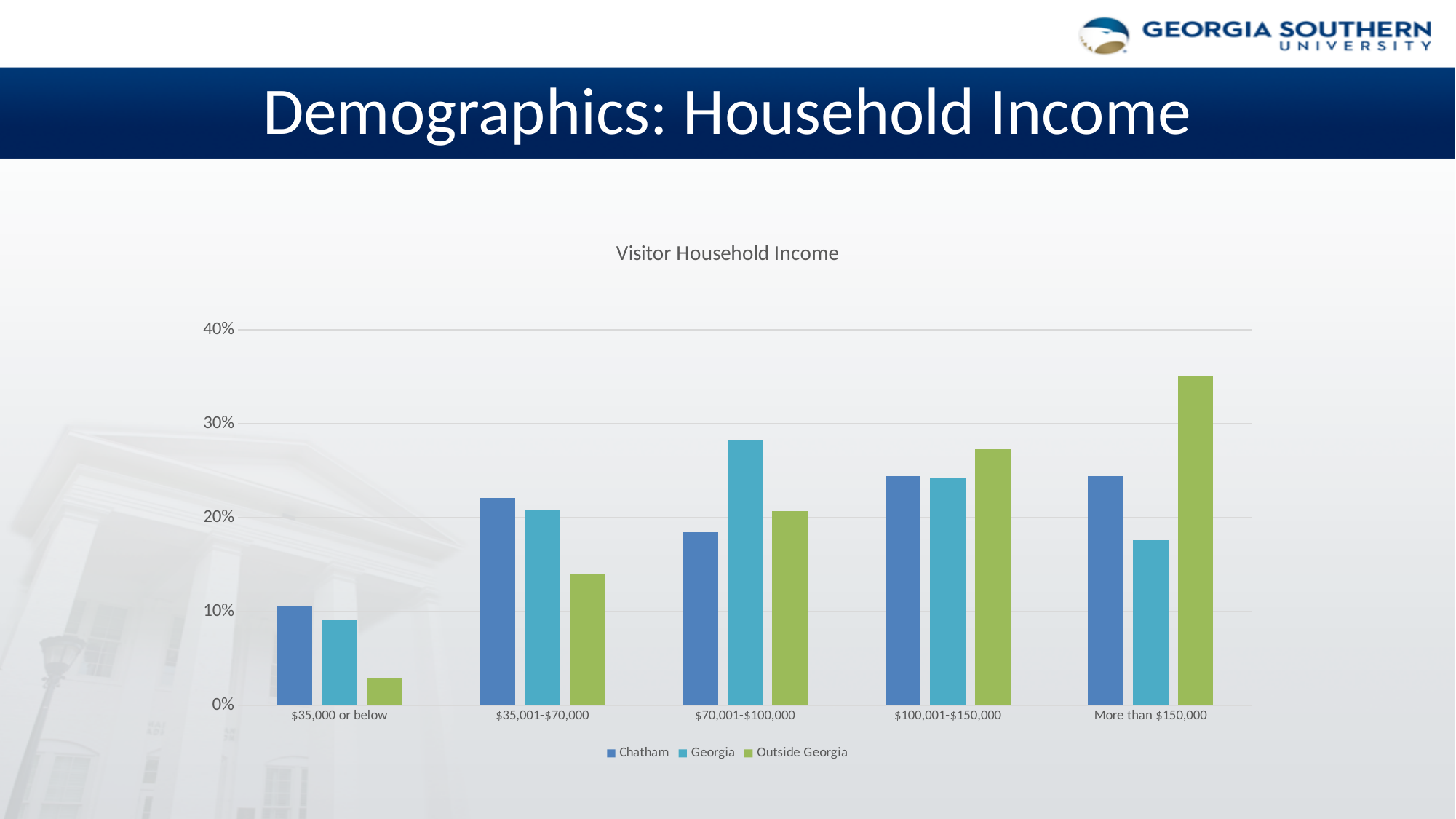
What kind of chart is shown on the slide? Bar chart Is the Outside Georgia value for More than $150,000 greater or less than 30%? greater What is the title of the chart? Visitor Household Income How many income categories are shown on the x axis of the chart? 5 For which income category is the Georgia value highest? $70,001-$100,000 Is the Outside Georgia value for $35,000 or below greater or less than 10%? less In the $70,001-$100,000 category, which is larger: Chatham or Georgia? Georgia For which income category is the Outside Georgia value highest? More than $150,000 For which income category is the Outside Georgia value lowest? $35,000 or below Do the Outside Georgia values rise or fall as income categories increase along the x axis? rise Is the Georgia value for $70,001-$100,000 greater or less than 20%? greater How many series does the legend of the Visitor Household Income chart list? 3